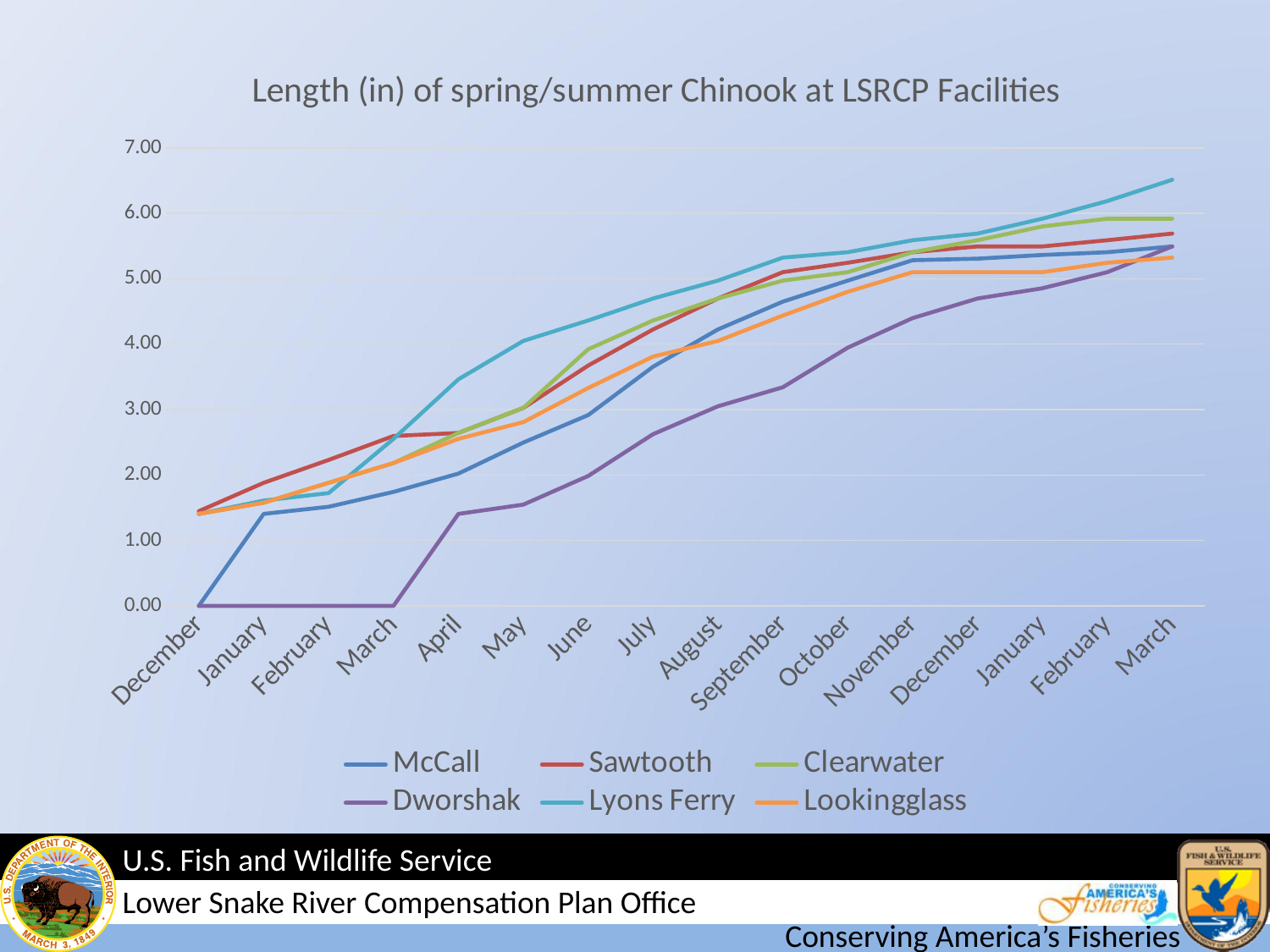
What is the title of the chart? Length (in) of spring/summer Chinook at LSRCP Facilities Which series has the lowest value in July? Dworshak What is the value for Dworshak in the first March? 0.00 Which series has the highest value in the final March? Lyons Ferry Is the value for Lyons Ferry in the final March greater or less than 6.00? greater What is the value for McCall in the first December? 0.00 What kind of chart is shown on the slide? line chart How many months are shown along the x axis? 16 Which is larger in April, the value for Lyons Ferry or the value for McCall? Lyons Ferry Is the value for Dworshak in July greater or less than 3.00? less How many series does the legend list? 6 Do the values for Lyons Ferry rise or fall from December to the final March? rise